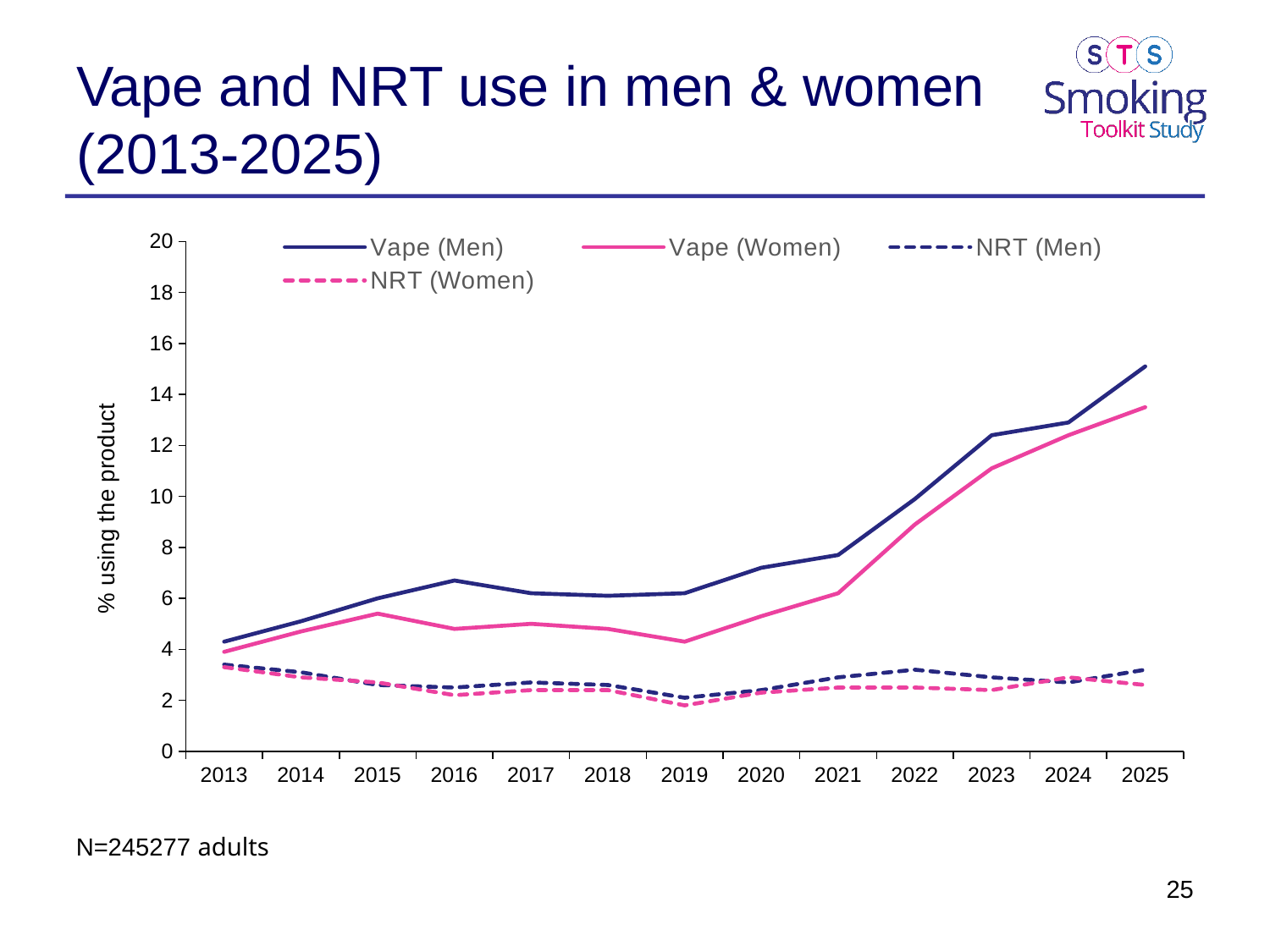
Is the value for Vape (Men) in 2025 greater or less than 14? greater What is the title of the y axis? % using the product Does Vape (Men) rise or fall from 2021 to 2025? rise In 2016, which is larger: Vape (Women) or NRT (Women)? Vape (Women) Is the value for NRT (Men) in 2013 greater or less than 4? less How many series does the legend list? 4 In which year is NRT (Women) at its lowest? 2019 How many years are shown along the x axis? 13 Is the value for Vape (Women) in 2019 greater or less than 6? less What kind of chart is shown on the slide? line chart In 2023, which is larger: Vape (Men) or Vape (Women)? Vape (Men) In which year is Vape (Men) at its highest? 2025